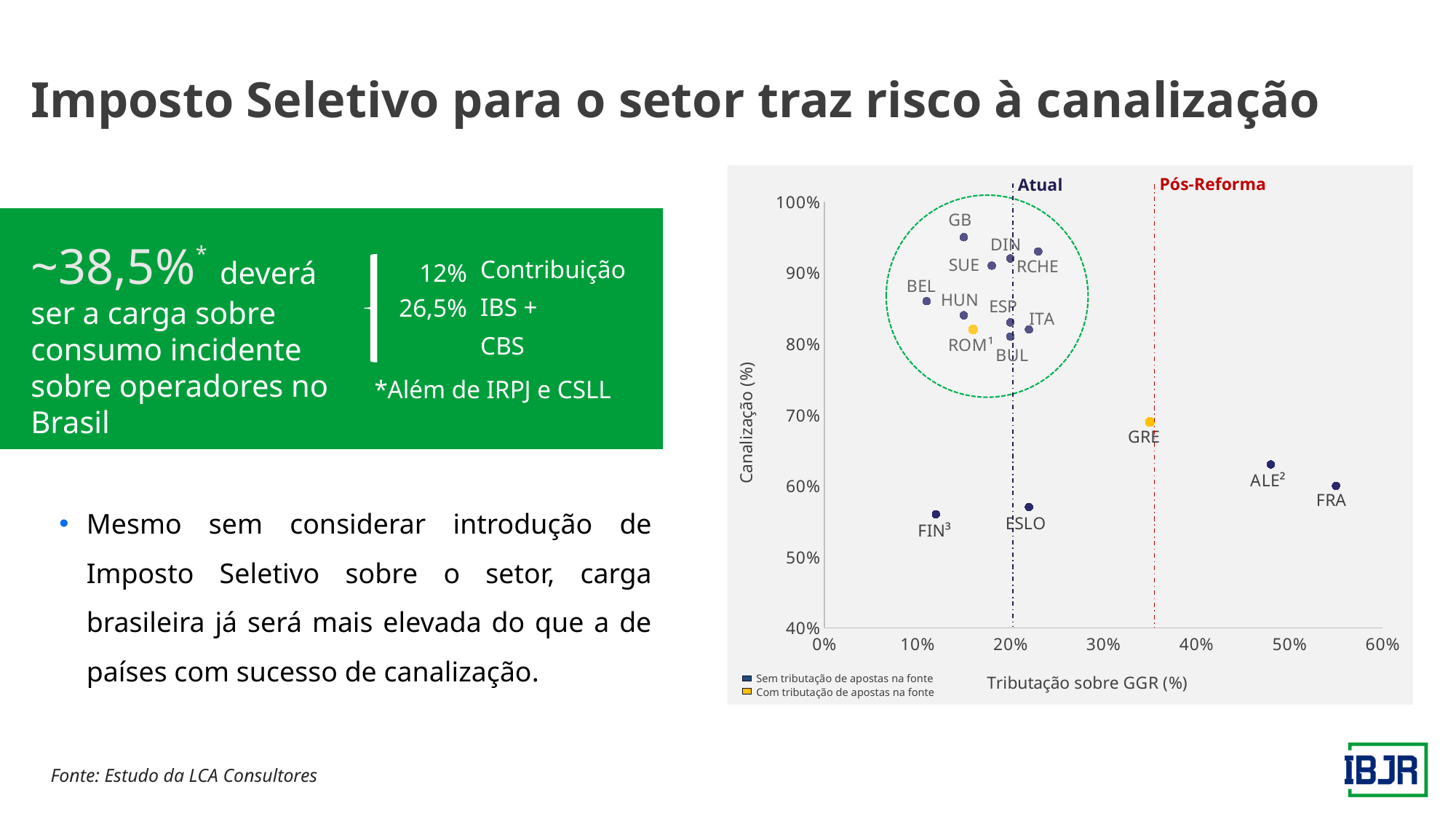
Is the Canalização value for FIN³ greater or less than 60%? less What kind of chart is shown on the slide? Scatter chart Which has the higher Canalização (%): GB or FRA? GB How many series does the chart legend list? 2 How many countries are plotted as points on the chart? 15 Is the Canalização value for GB greater or less than 90%? greater Which country has the highest Tributação sobre GGR (%) on the chart? FRA Is the Tributação sobre GGR value for FRA greater or less than 50%? greater What is the label of the chart's x axis? Tributação sobre GGR (%) Which country has the highest Canalização (%) on the chart? GB Which has the higher Tributação sobre GGR (%): ALE² or FRA? FRA